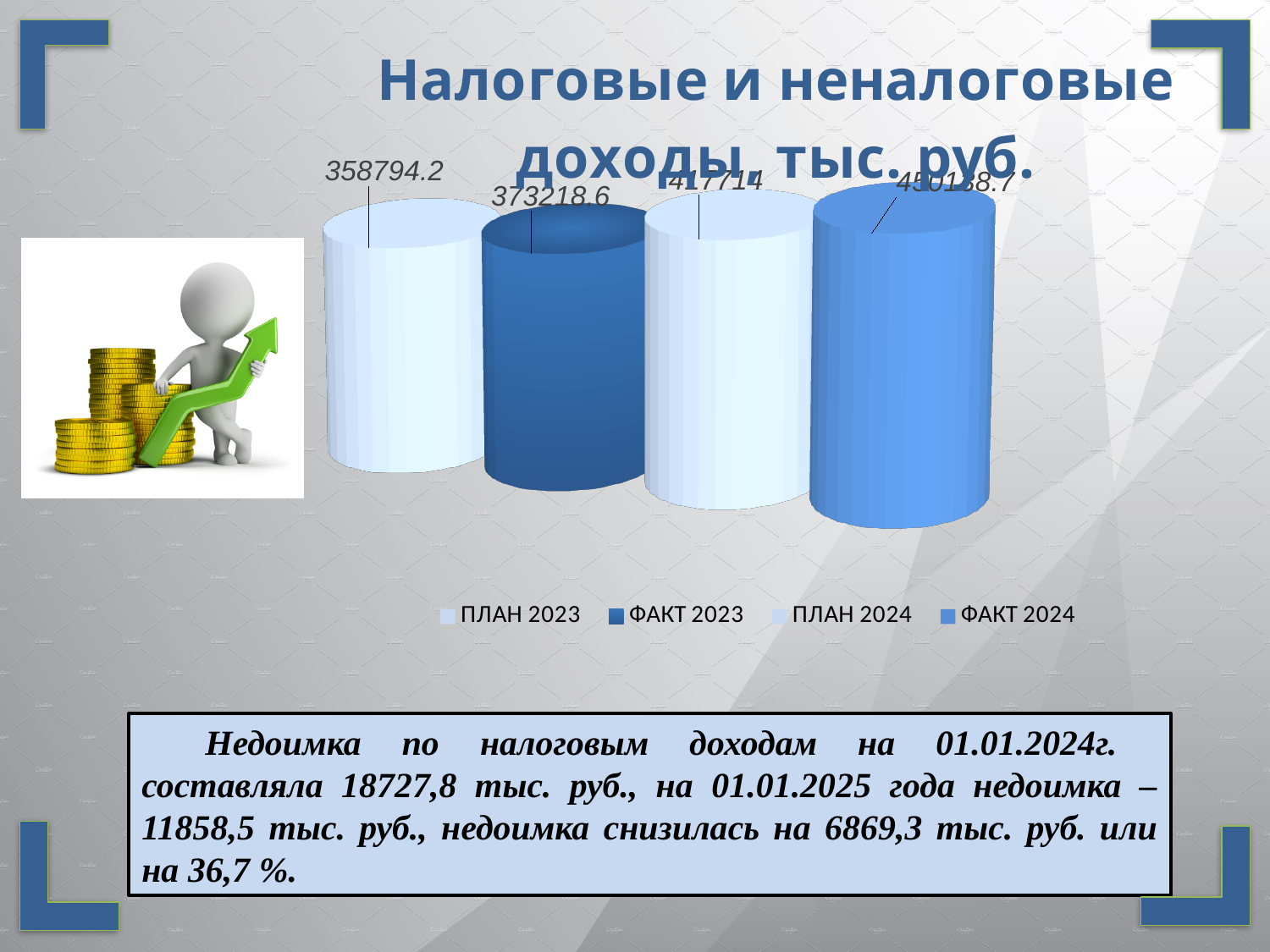
What is the difference between ПЛАН 2024 and ФАКТ 2023? 44495.4 What is the difference between ФАКТ 2023 and ПЛАН 2023? 14424.4 What is the value for ФАКТ 2023? 373218.6 What kind of chart is shown on the slide? Bar chart How many series does the legend list? 4 What is the title of the chart? Налоговые и неналоговые доходы, тыс. руб. Which is larger, ПЛАН 2024 or ФАКТ 2023? ПЛАН 2024 What is the value for ПЛАН 2024? 417714 Which series has the highest value? ФАКТ 2024 What is the value for ПЛАН 2023? 358794.2 Which series has the lowest value? ПЛАН 2023 Do the values rise or fall from left to right across the bars? Rise